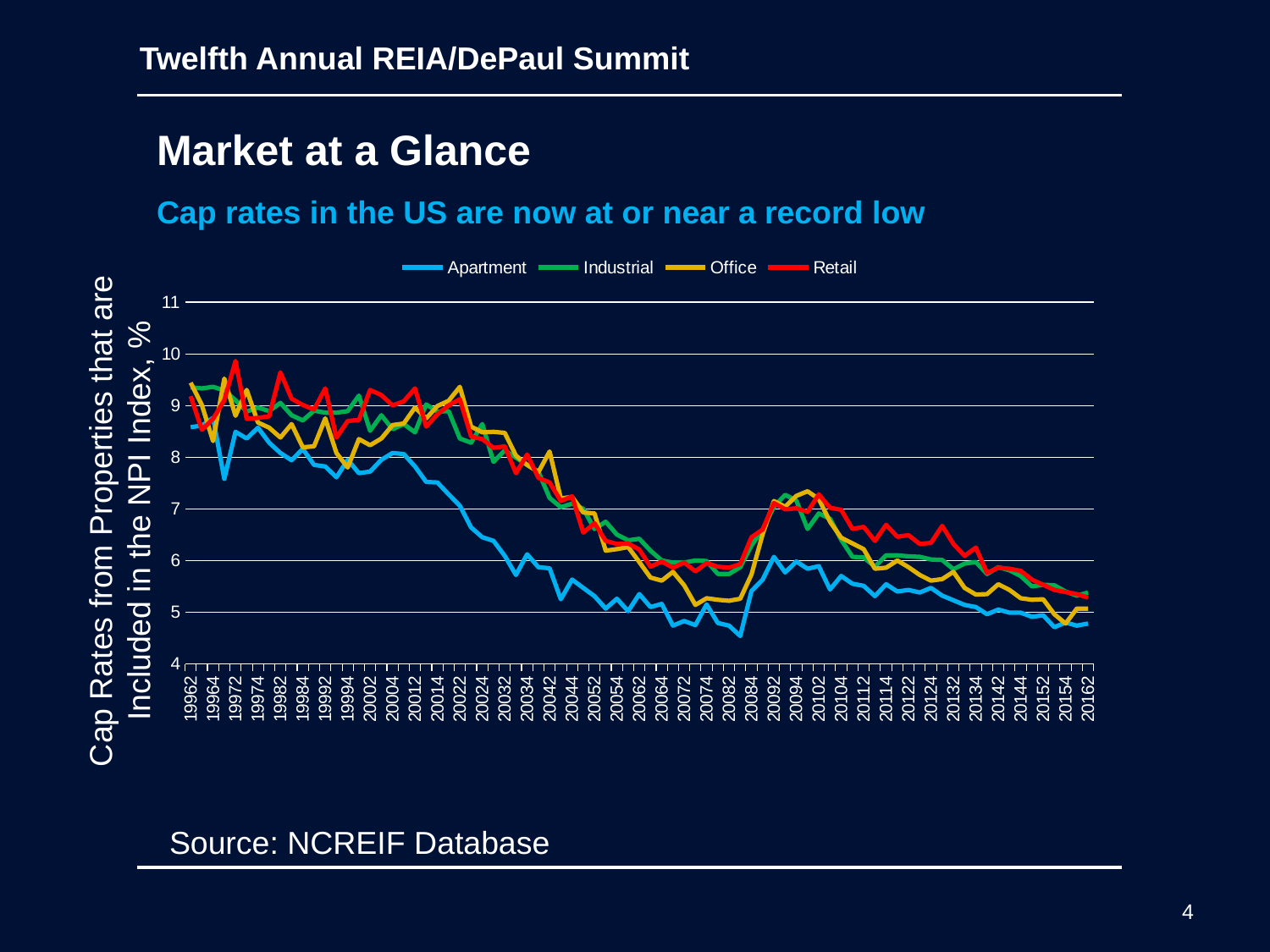
Is the Apartment value at 20084 greater or less than 5? greater At 20162, which is higher: the Retail line or the Apartment line? Retail How many series does the legend list? 4 Which series has the lowest value at 20162? Apartment What is the y-axis title of the chart? Cap Rates from Properties that are Included in the NPI Index, % Which series has the highest value at 19972? Retail Is the Apartment value at 20162 greater or less than 5? less Is the Retail value at 20162 greater or less than 5? greater Which series are listed in the chart legend? Apartment, Industrial, Office, Retail What kind of chart is shown on the slide? Line chart Does the Apartment cap rate generally rise or fall from 19962 to 20162? Fall